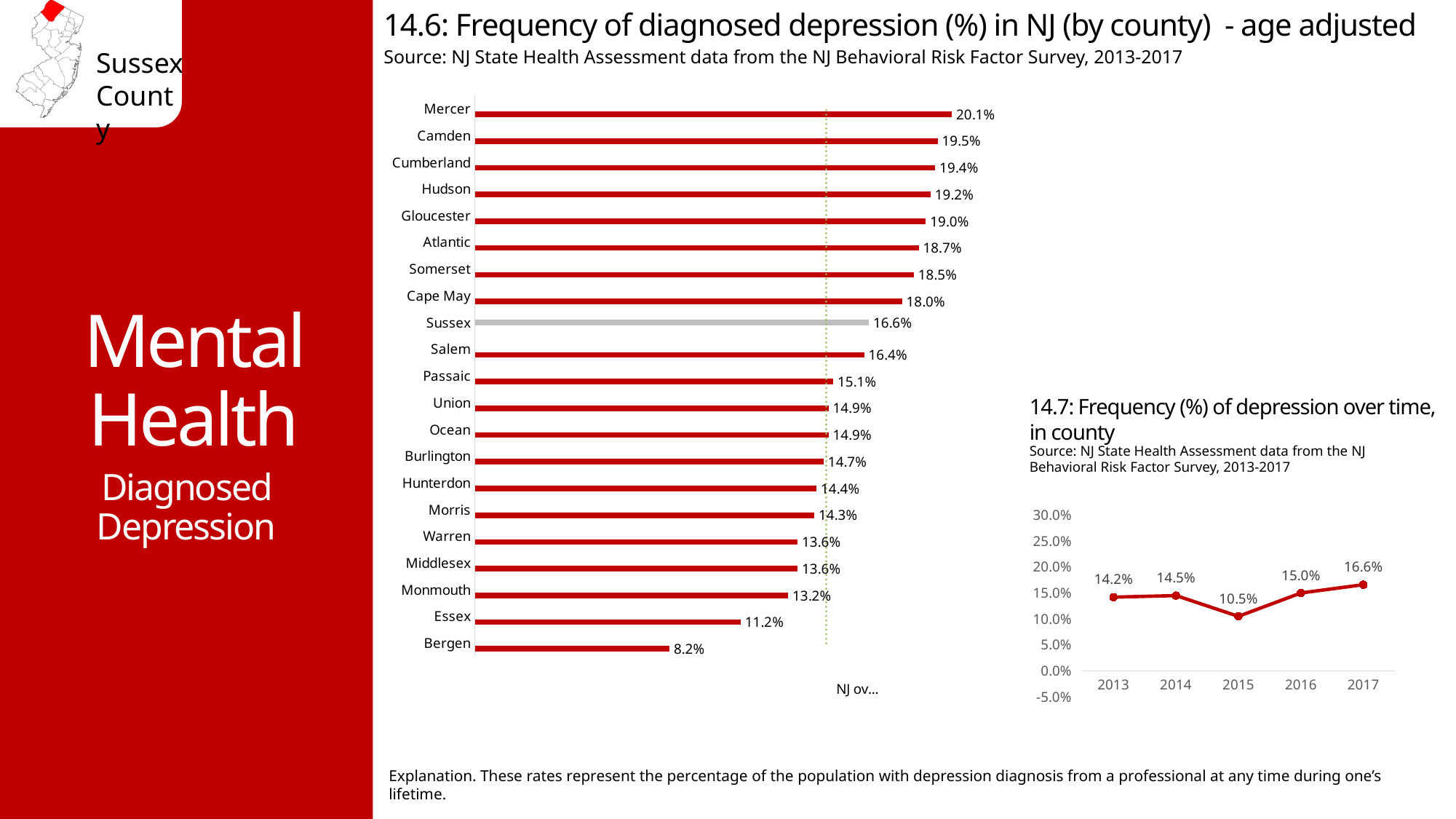
What kind of chart is chart 14.7 (frequency of depression over time)? Line chart What kind of chart is chart 14.6 (frequency of diagnosed depression by county)? Bar chart In the chart 14.6 (frequency of diagnosed depression by county), which is larger, Hudson or Salem? Hudson In the chart 14.6 (frequency of diagnosed depression by county), which county has the highest value? Mercer In the chart 14.6 (frequency of diagnosed depression by county), what is the value for Sussex? 16.6% In the chart 14.7 (frequency of depression over time), which year has the highest value? 2017 In the chart 14.6 (frequency of diagnosed depression by county), which county has the lowest value? Bergen In the chart 14.6 (frequency of diagnosed depression by county), what is the value for Essex? 11.2% In the chart 14.7 (frequency of depression over time), what is the value for 2015? 10.5% In the chart 14.6 (frequency of diagnosed depression by county), how many counties are shown? 21 In the chart 14.6 (frequency of diagnosed depression by county), what is the difference between Mercer and Bergen? 11.9% In the chart 14.7 (frequency of depression over time), what is the difference between 2017 and 2013? 2.4%